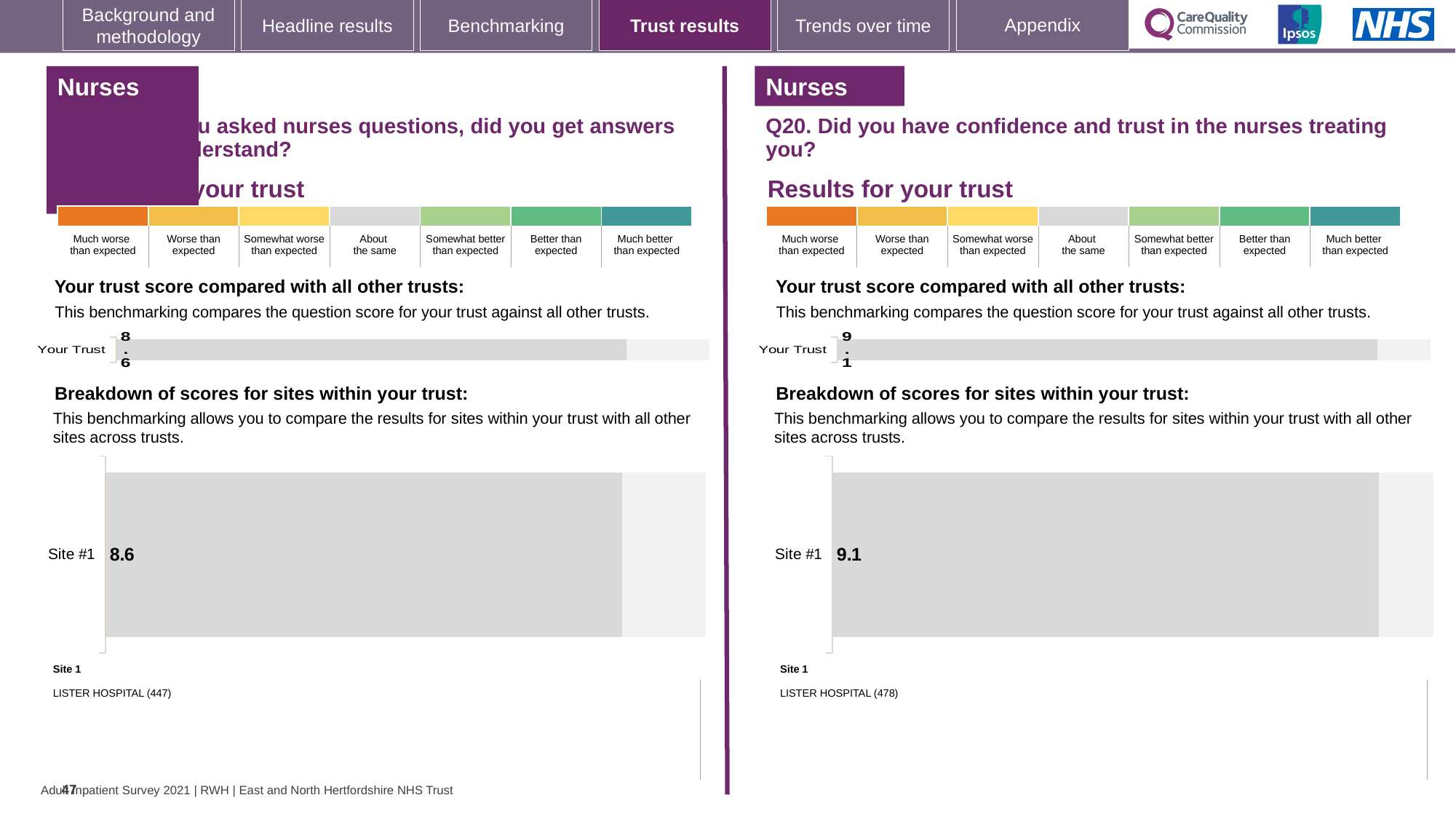
On the left panel, what is the score for Site #1 in the 'Breakdown of scores for sites within your trust' chart? 8.6 On the right panel (Q20), which hospital is listed as Site 1 below the site breakdown chart? LISTER HOSPITAL (478) How many sites are shown in the 'Breakdown of scores for sites within your trust' chart on the left panel? 1 What is the difference between the Site #1 score on the right panel (Q20) and the Site #1 score on the left panel? 0.5 On the right panel (Q20. Did you have confidence and trust in the nurses treating you?), what is the score shown for Your Trust? 9.1 How many sites are shown in the 'Breakdown of scores for sites within your trust' chart on the right panel (Q20)? 1 Which is larger: the Your Trust score on the left panel or the Your Trust score on the right panel (Q20)? Right panel (Q20) On the left panel, which hospital is listed as Site 1 below the site breakdown chart? LISTER HOSPITAL (447) On the left panel, what is the score shown for Your Trust in the 'Your trust score compared with all other trusts' chart? 8.6 On the right panel (Q20), what is the score for Site #1 in the 'Breakdown of scores for sites within your trust' chart? 9.1 What type of chart is used to show the Your Trust score on the left panel? Bar chart What type of chart is used to show the Site #1 score on the right panel (Q20)? Bar chart